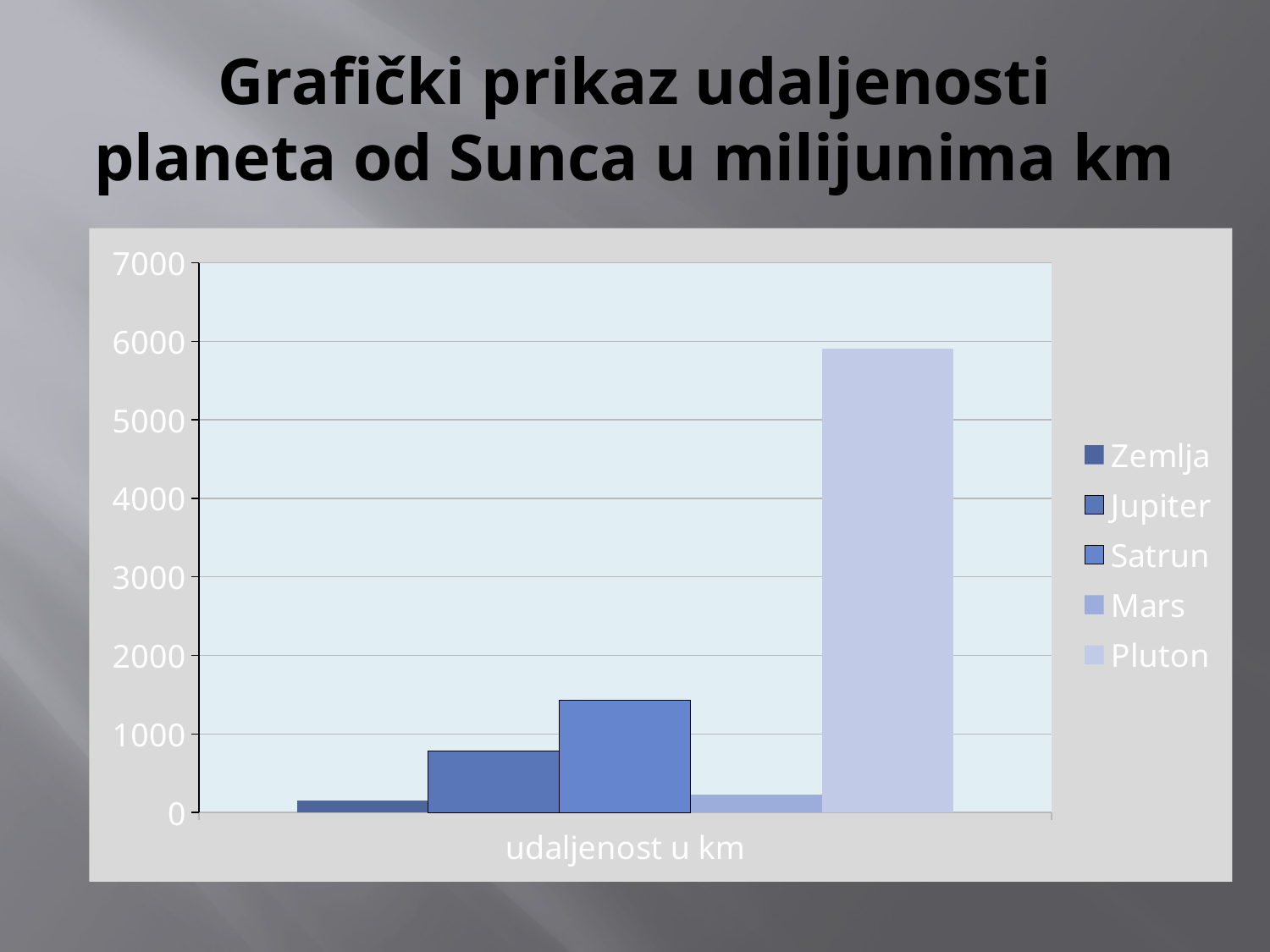
Which is larger, the value for Satrun or the value for Jupiter? Satrun What is the title of the slide? Grafički prikaz udaljenosti planeta od Sunca u milijunima km Which series has the highest value in the chart? Pluton Is the value for Mars greater or less than 1000? less What is the label on the x axis of the chart? udaljenost u km What kind of chart is shown on the slide? bar chart Which is larger, the value for Jupiter or the value for Mars? Jupiter Is the value for Satrun greater or less than 1000? greater How many series does the legend list? 5 How many categories are shown on the x axis? 1 Is the value for Pluton greater or less than 5000? greater